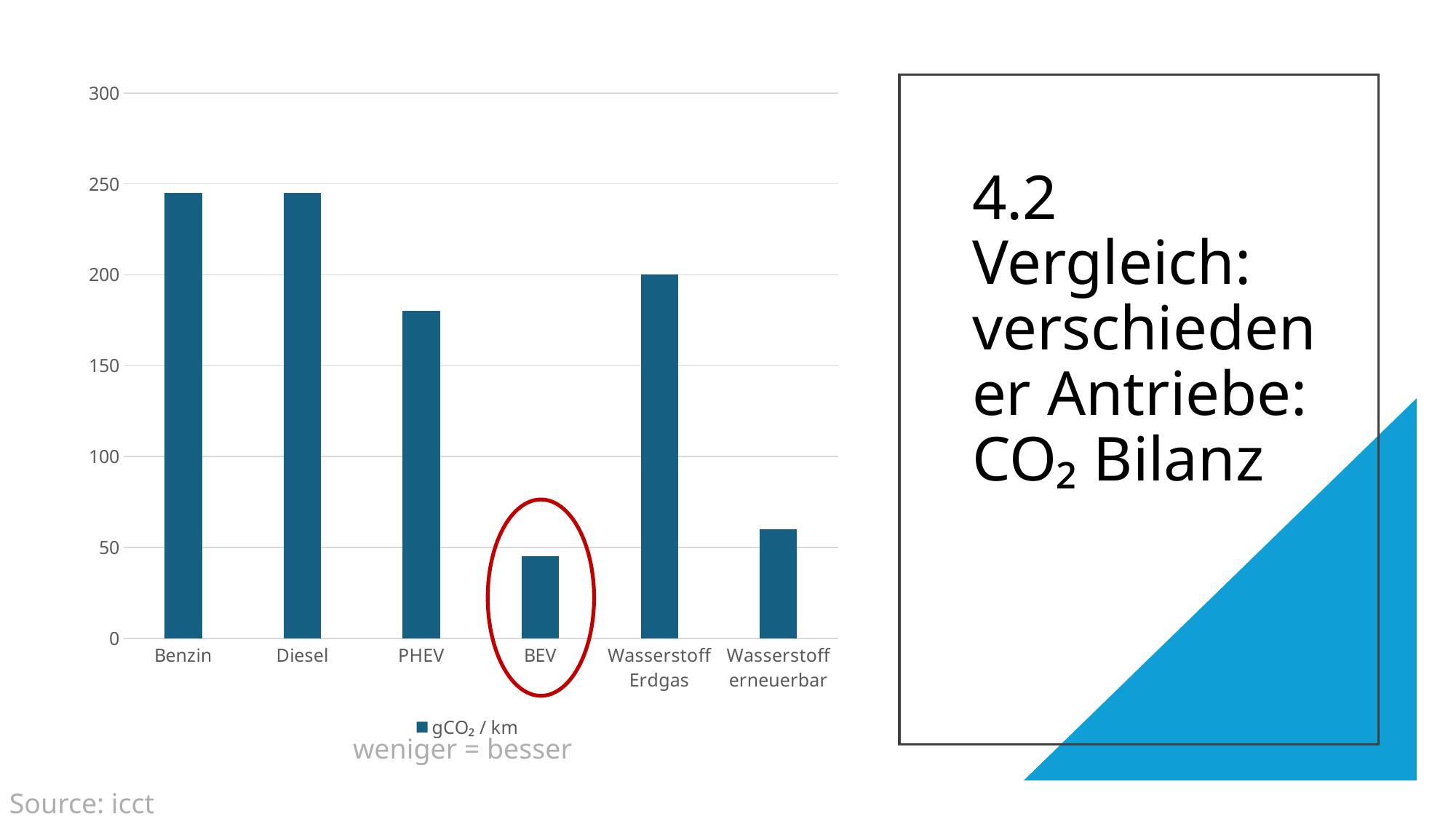
Which has the larger value, PHEV or Wasserstoff Erdgas? Wasserstoff Erdgas Which category has the lowest value in the chart? BEV How many categories are shown on the x axis of the chart? 6 How many series does the chart's legend list? 1 What is the legend entry of the chart? gCO₂ / km What is the value for Wasserstoff Erdgas? 200 Is the value for Benzin greater or less than 200? greater Is the value for PHEV greater or less than 150? greater What kind of chart is shown on the slide? bar chart Is the value for BEV greater or less than 50? less Which has the larger value, BEV or Wasserstoff erneuerbar? Wasserstoff erneuerbar